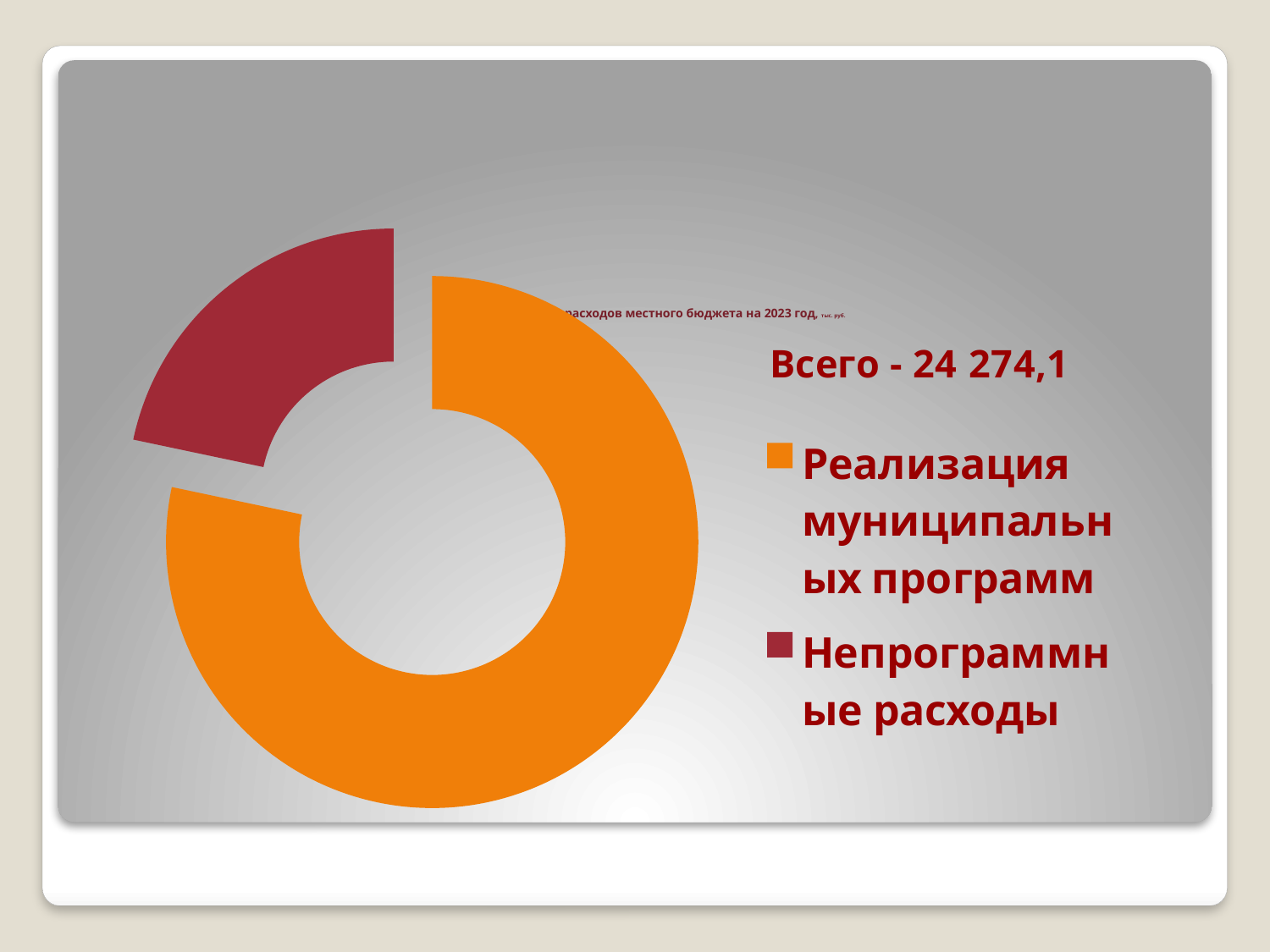
What colour is the slice for Непрограммные расходы? Dark red What kind of chart is shown on the slide? Doughnut (pie) chart What total value is stated next to the chart (Всего)? 24 274,1 Which category has the smallest slice in the chart? Непрограммные расходы Which category has the largest slice in the chart? Реализация муниципальных программ Which slice is larger: Реализация муниципальных программ or Непрограммные расходы? Реализация муниципальных программ How many entries does the legend list? 2 How many slices does the doughnut chart have? 2